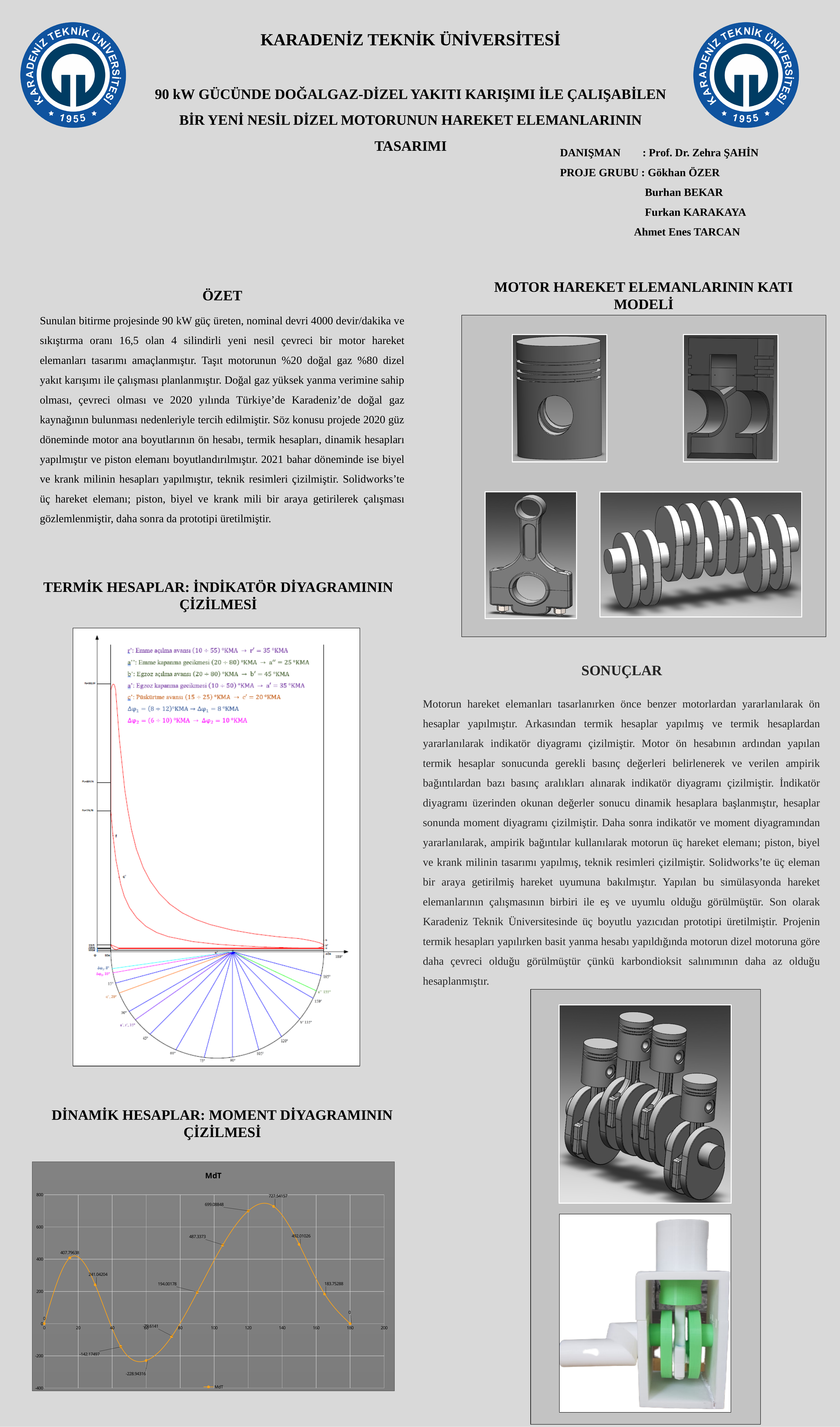
What is the lowest data-labelled value on the MdT chart? -228.94316 What is the title of the chart under 'DİNAMİK HESAPLAR: MOMENT DİYAGRAMININ ÇİZİLMESİ'? MdT On the MdT chart, does the curve rise or fall between x = 100 and x = 130? rise On the MdT chart, what is the data label of the point just before the highest peak? 699.08848 How many series does the legend of the MdT chart list? 1 On the MdT chart, what is the value of the first peak (near the start of the curve)? 407.79638 On the MdT chart, which is larger: 487.3373 or 492.01026? 492.01026 What kind of chart is the MdT chart? line chart What is the highest data-labelled value on the MdT chart? 727.54157 On the MdT chart, what is the difference between the highest value 727.54157 and the preceding point 699.08848? 28.45309 On the MdT chart, is the highest value greater or less than 600? greater How many data points are plotted on the MdT chart? 13